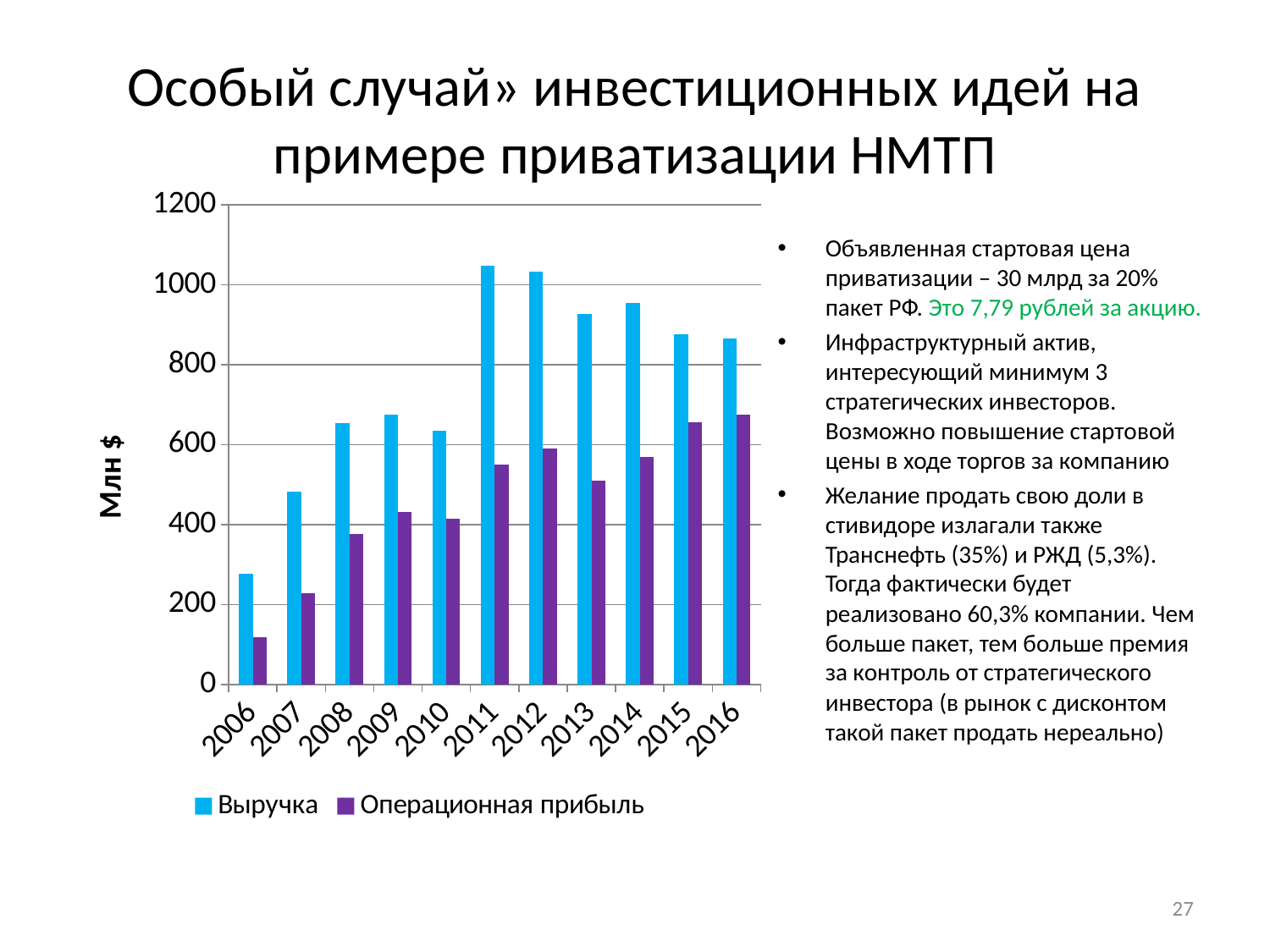
Which year has the lowest Выручка value? 2006 How many years are shown on the x axis of the chart? 11 Does the Выручка value rise or fall from 2006 to 2011? rise Which is larger, the Выручка value for 2007 or for 2008? 2008 Is the Выручка value for 2011 greater or less than 1000? greater What is the label on the vertical axis of the chart? Млн $ What kind of chart is shown on the slide? Bar chart How many series does the chart legend list? 2 Is the Операционная прибыль value for 2016 greater or less than 600? greater Is the Операционная прибыль value for 2006 greater or less than 200? less Which year has the lowest Операционная прибыль value? 2006